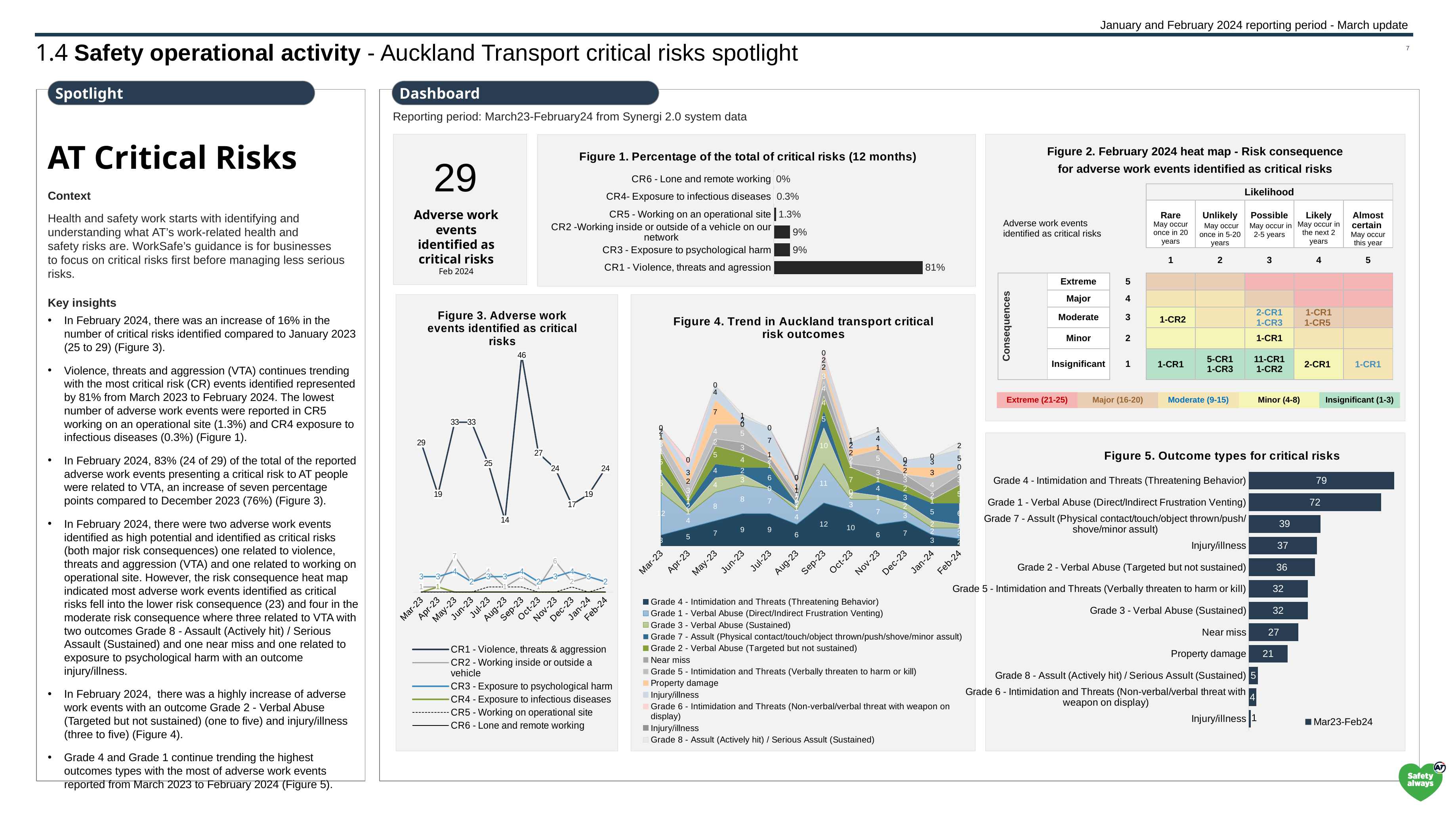
How many critical risk categories are plotted in Figure 1? 6 In Figure 1, which critical risk category has the lowest percentage? CR6 - Lone and remote working In Figure 3, in which month does the CR1 - Violence, threats & aggression line reach its lowest value? Aug-23 In Figure 3, is the CR1 value for Jan-24 larger or smaller than the CR1 value for Feb-24? smaller In Figure 1, what percentage is shown for CR1 - Violence, threats and agression? 81% In Figure 4, what is the value of Grade 4 - Intimidation and Threats (Threatening Behavior) for Sep-23? 12 In Figure 1, what is the difference in percentage points between CR1 - Violence, threats and agression and CR3 - Exposure to psychological harm? 72 In Figure 5, what is the value for Grade 1 - Verbal Abuse (Direct/Indirect Frustration Venting)? 72 What type of chart is Figure 5? bar chart How many series does the legend of Figure 3 list? 6 In Figure 3, what is the value of the CR1 - Violence, threats & aggression line for Sep-23? 46 In Figure 5, which outcome type has the highest value? Grade 4 - Intimidation and Threats (Threatening Behavior)